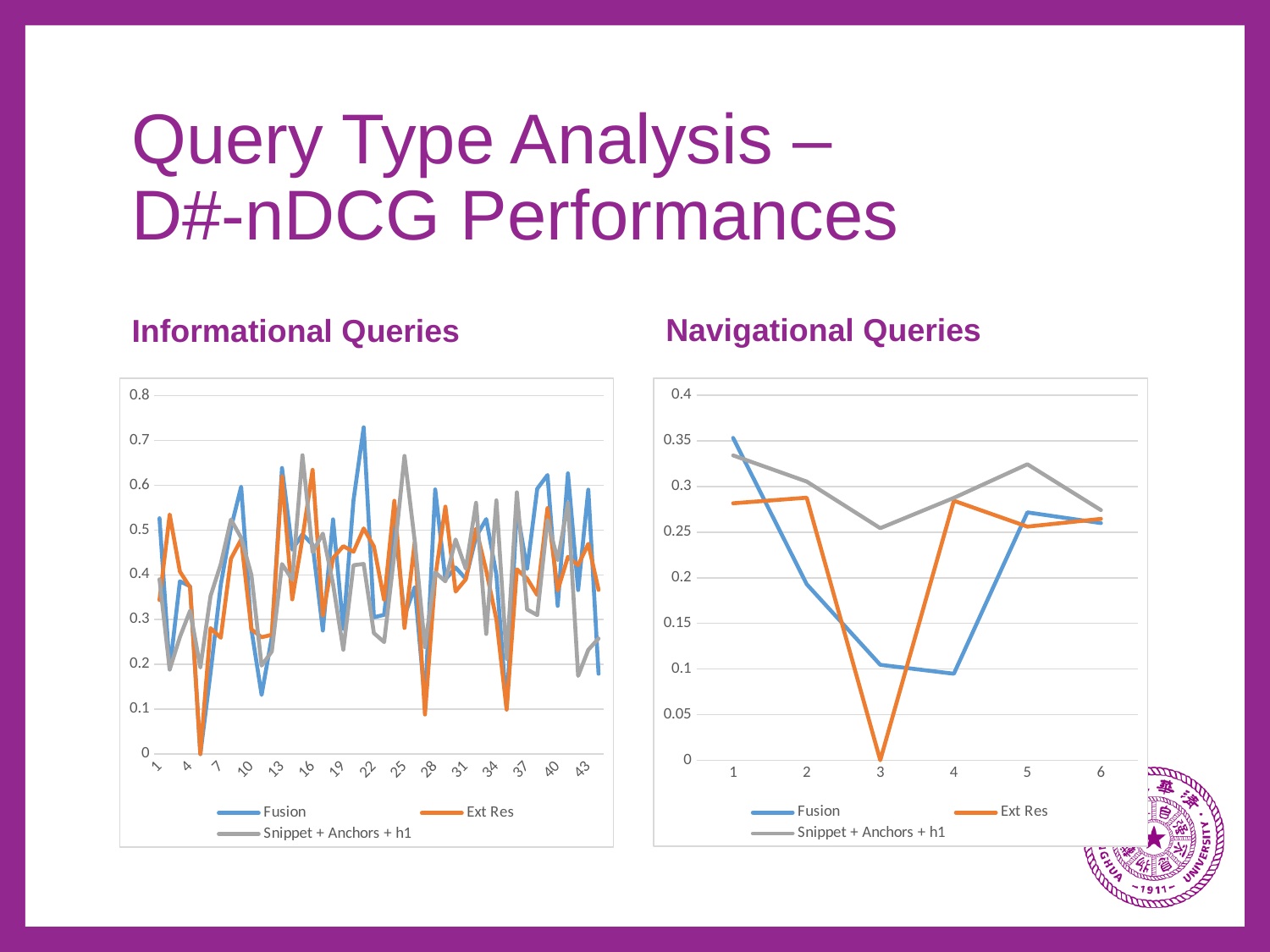
In the Navigational Queries chart, is the Ext Res value at query 3 greater or less than 0.05? less In the Navigational Queries chart, is the Fusion value at query 4 greater or less than 0.15? less In the Navigational Queries chart, at query 3, which series has the higher value: Fusion or Snippet + Anchors + h1? Snippet + Anchors + h1 In the Navigational Queries chart, is the Fusion value at query 1 greater or less than 0.3? greater How many query points are plotted along the x axis of the Navigational Queries chart? 6 In the Navigational Queries chart, which series are listed in the legend? Fusion, Ext Res, Snippet + Anchors + h1 What kind of chart is the Informational Queries chart? line chart What kind of chart is the Navigational Queries chart? line chart In the Navigational Queries chart, does the Fusion series rise or fall from query 1 to query 4? fall In the Navigational Queries chart, at which query does the Ext Res series reach its lowest value? 3 How many series does the legend of the Navigational Queries chart list? 3